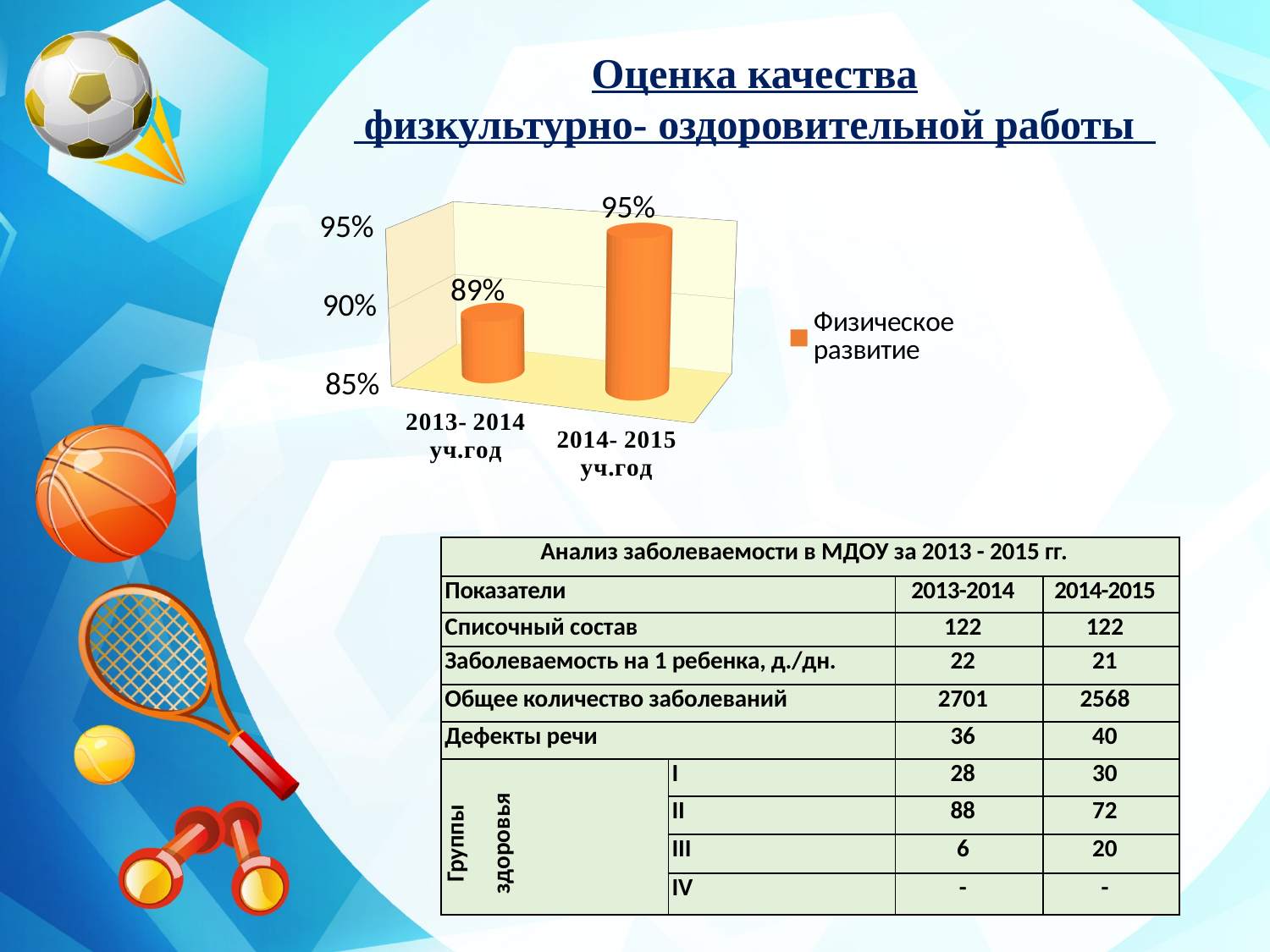
How many categories are shown in the chart? 2 What is the name of the series shown in the chart legend? Физическое развитие Which is larger: the value for 2013- 2014 уч.год or for 2014- 2015 уч.год? 2014- 2015 уч.год What kind of chart is shown on the slide? bar chart What is the value for 2013- 2014 уч.год in the chart? 89% Which year has the highest value in the chart? 2014- 2015 уч.год Is the value for 2014- 2015 уч.год greater or less than 90%? greater Is the value for 2013- 2014 уч.год greater or less than 90%? less What is the value for 2014- 2015 уч.год in the chart? 95% What is the difference between the values for 2014- 2015 уч.год and 2013- 2014 уч.год? 6% Which year has the lowest value in the chart? 2013- 2014 уч.год How many series does the chart legend list? 1